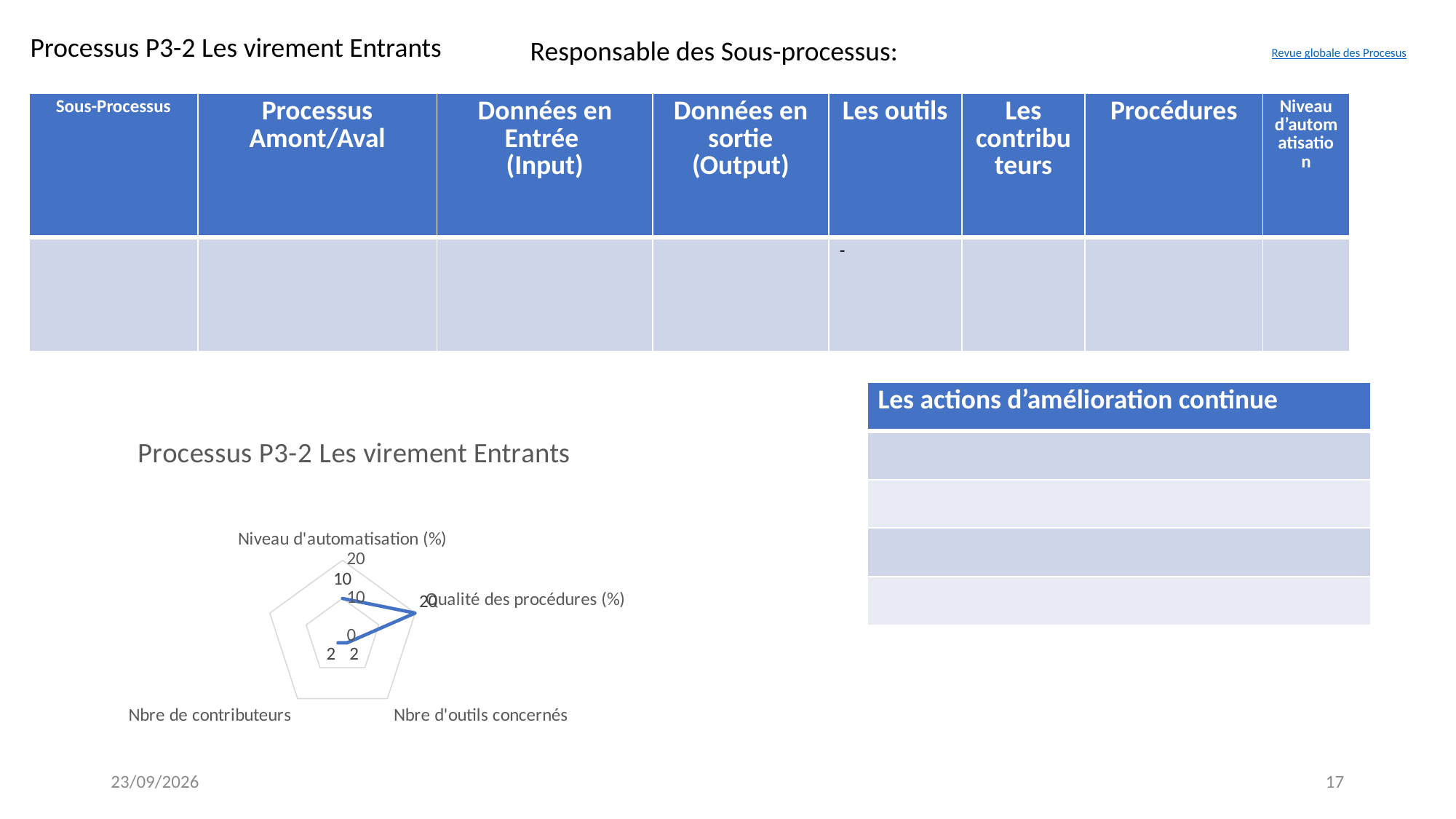
What kind of chart is shown on the slide? Radar chart What is the value for Nbre de contributeurs in the chart? 2 What is the difference between the values for Qualité des procédures (%) and Niveau d'automatisation (%)? 10 What is the maximum value shown on the chart's axis scale? 20 Which is larger, the value for Niveau d'automatisation (%) or the value for Nbre d'outils concernés? Niveau d'automatisation (%) What is the title of the chart? Processus P3-2 Les virement Entrants What is the value for Niveau d'automatisation (%) in the chart? 10 What is the value for Nbre d'outils concernés in the chart? 2 Which category has the highest value in the chart? Qualité des procédures (%) What is the value for Qualité des procédures (%) in the chart? 20 Which is larger, the value for Qualité des procédures (%) or the value for Niveau d'automatisation (%)? Qualité des procédures (%)